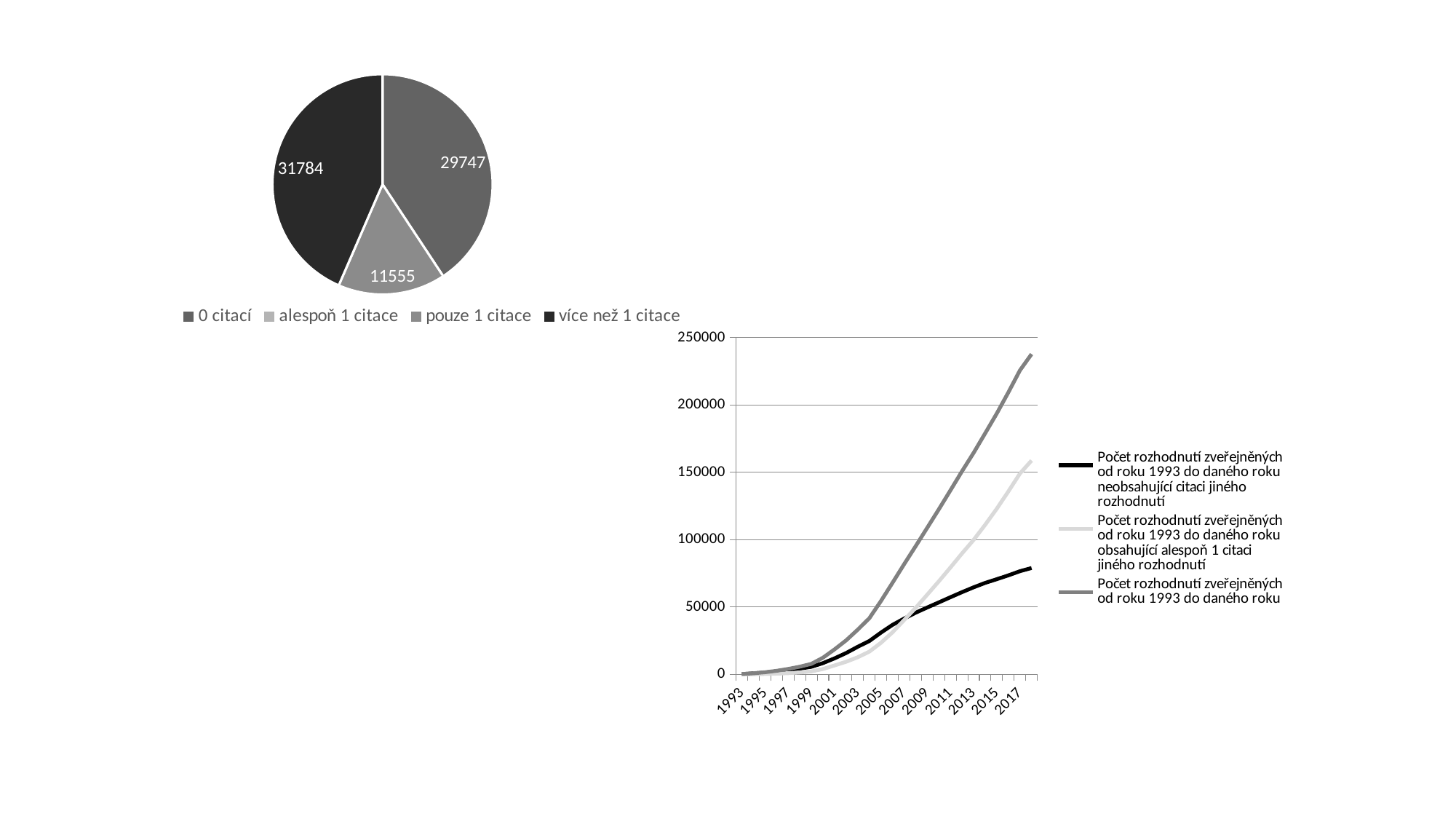
In the pie chart, what value is shown for the 'pouze 1 citace' slice? 11555 In the line chart, is the value of the 'Počet rozhodnutí zveřejněných od roku 1993 do daného roku neobsahující citaci jiného rozhodnutí' series in 2017 greater or less than 100000? less In the pie chart, what is the difference between the '0 citací' slice and the 'pouze 1 citace' slice? 18192 What kind of chart is the chart at the top left of the slide? pie chart In the line chart, is the value of the 'Počet rozhodnutí zveřejněných od roku 1993 do daného roku' series in 2017 greater or less than 200000? greater In the line chart, do the values of the series rise or fall from 1993 to 2017? rise In the line chart, how many series does the legend list? 3 What kind of chart is the chart at the bottom right of the slide? line chart In the pie chart, what value is shown for the '0 citací' slice? 29747 In the pie chart, which slice has the smallest value? pouze 1 citace In the pie chart, what value is shown for the 'více než 1 citace' slice? 31784 In the pie chart, how many entries does the legend list? 4